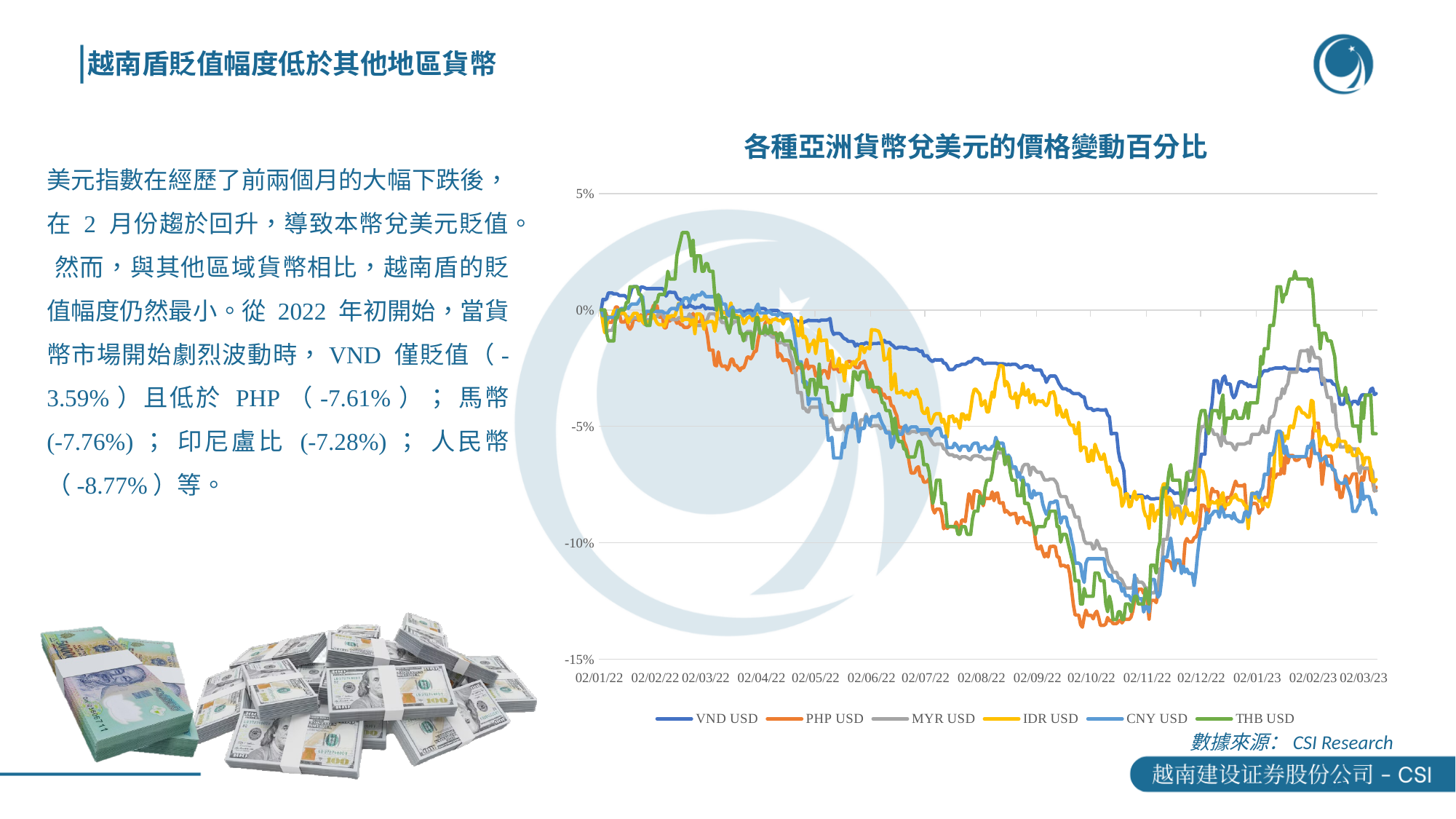
Is the value for PHP USD around 02/10/22 greater or less than -10%? less What kind of chart is shown on the slide? line chart Does the VND USD line rise or fall overall from 02/01/22 to 02/03/23? fall Is the value for CNY USD at 02/03/23 greater or less than -5%? less Which series has the highest value at the right end of the chart (02/03/23)? VND USD At 02/03/23, which is larger, the value for VND USD or the value for CNY USD? VND USD How many series does the legend of the chart list? 6 Is the value for VND USD at 02/03/23 greater or less than -5%? greater Which series is shown in green in the chart legend? THB USD How many date labels are shown along the x axis of the chart? 15 What is the title of the chart? 各種亞洲貨幣兌美元的價格變動百分比